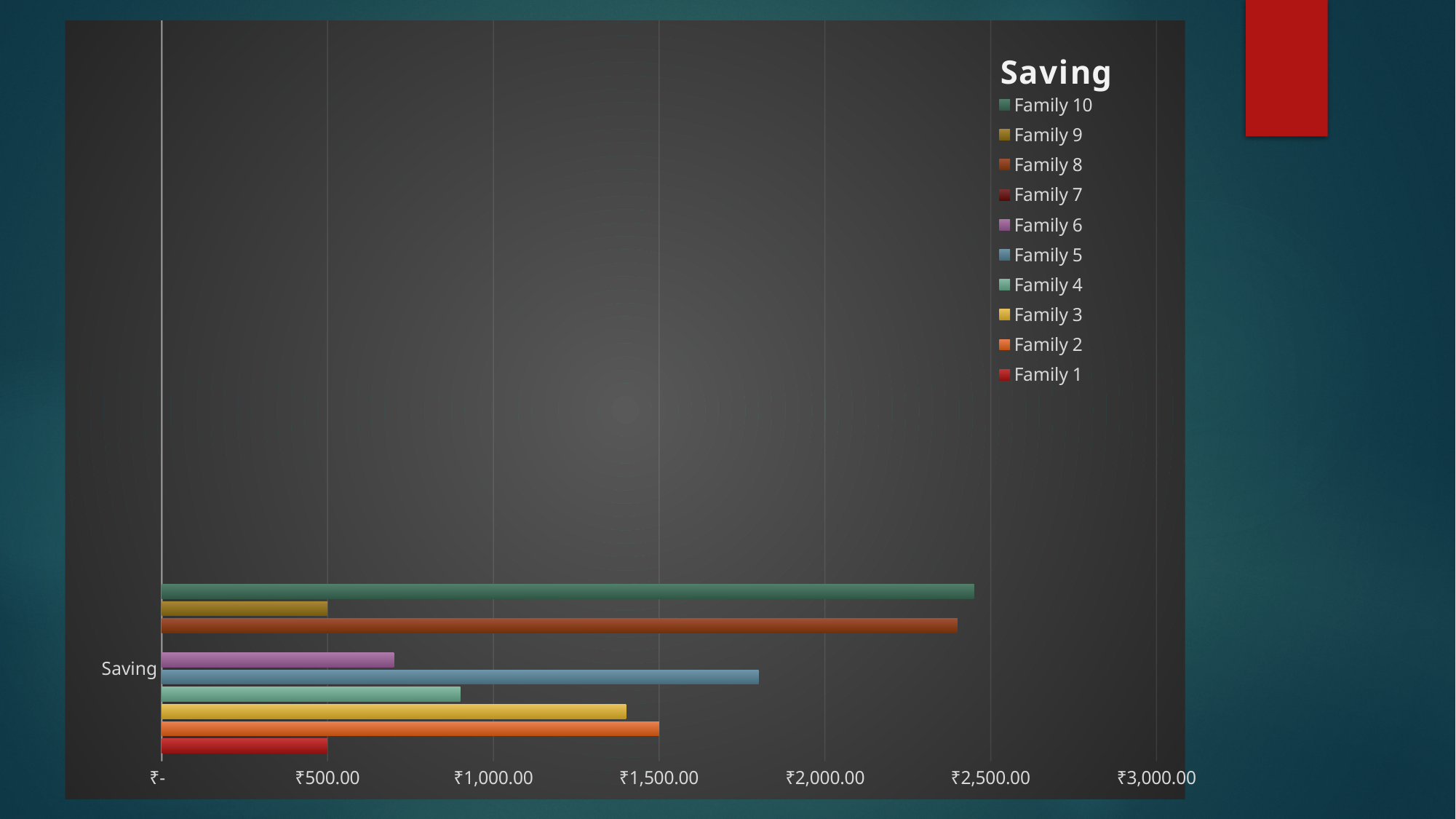
Which family has the lowest saving value? Family 7 What is the title of the chart? Saving How many series does the legend list? 10 Which family has the highest saving value? Family 10 Is the saving value for Family 6 greater or less than ₹1,000.00? less Which has a larger saving value, Family 4 or Family 6? Family 4 What is the saving value for Family 2? ₹1,500.00 How many categories are shown on the vertical axis? 1 Which has a larger saving value, Family 5 or Family 3? Family 5 What is the saving value for Family 1? ₹500.00 Is the saving value for Family 5 greater or less than ₹1,500.00? greater What kind of chart is shown on the slide? bar chart